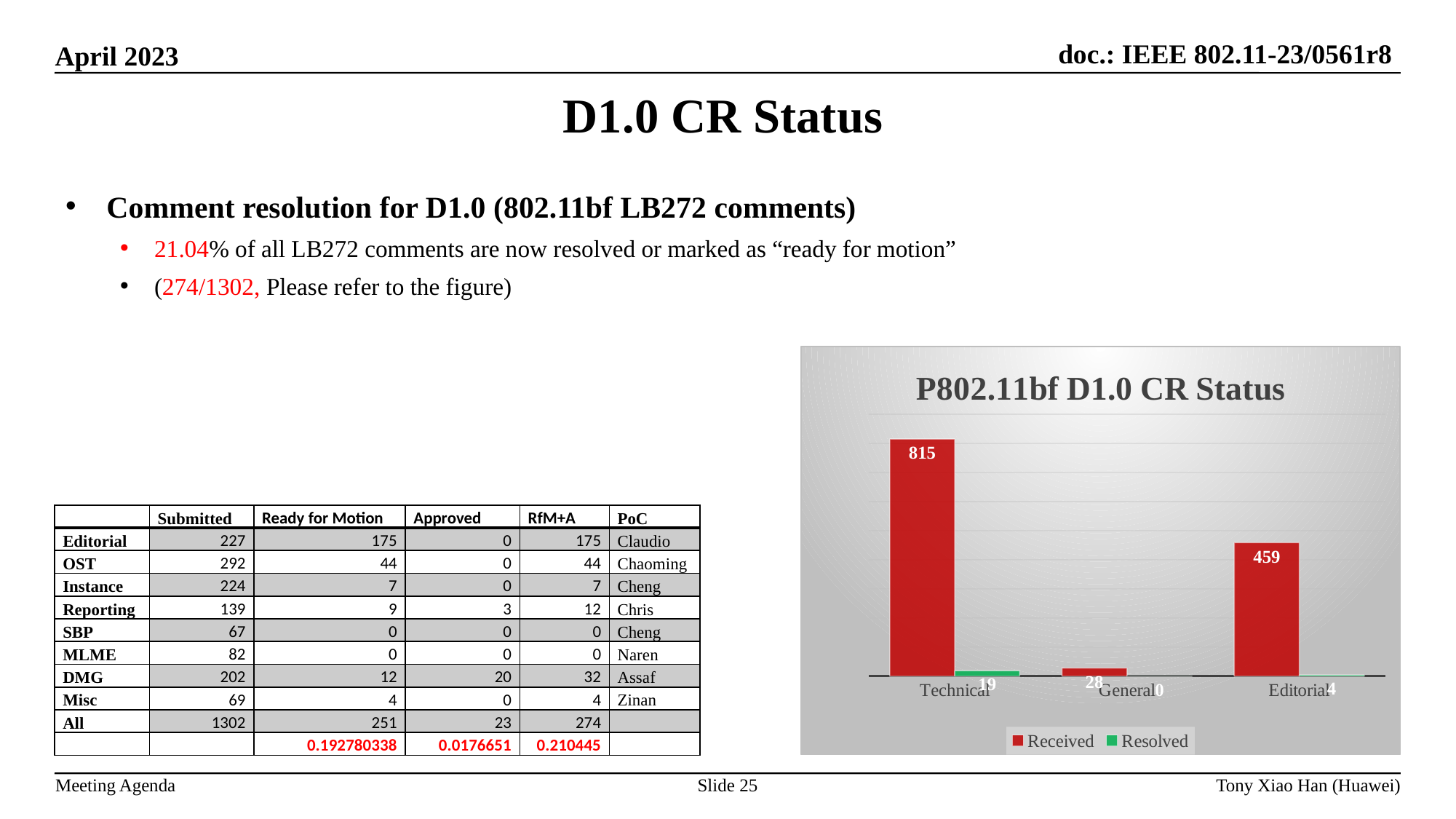
Which is larger, the Received value for Editorial or the Received value for General? Editorial How many series does the chart legend list? 2 What is the difference between the Received values for Technical and Editorial? 356 What is the title of the chart? P802.11bf D1.0 CR Status What is the Received value for Editorial? 459 What is the Received value for Technical? 815 What kind of chart is shown on the slide? bar chart What is the Resolved value for Technical? 19 How many categories are shown on the x axis of the chart? 3 Which category has the lowest Received value? General What is the Received value for General? 28 Which category has the highest Received value? Technical